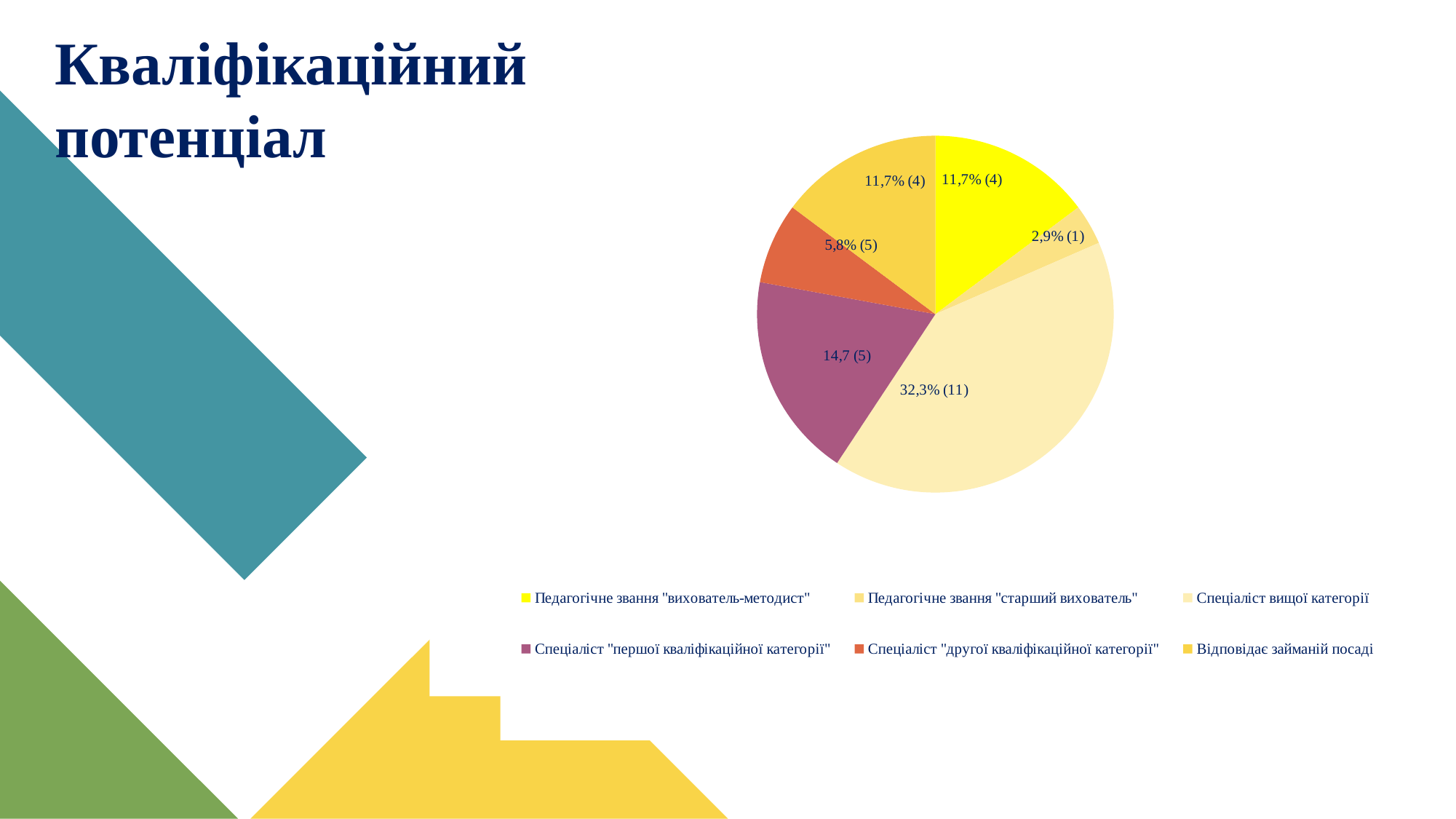
What is the title of the slide containing the chart? Кваліфікаційний потенціал How many slices does the pie chart have? 6 Which category has the smallest slice of the pie? Педагогічне звання "старший вихователь" What is the data label for the slice "Спеціаліст "другої кваліфікаційної категорії""? 5,8% (5) What is the data label for the slice "Спеціаліст вищої категорії"? 32,3% (11) How many entries does the legend list? 6 Which slice is larger: "Спеціаліст "першої кваліфікаційної категорії"" or "Спеціаліст "другої кваліфікаційної категорії""? Спеціаліст "першої кваліфікаційної категорії" What is the data label for the slice "Педагогічне звання "вихователь-методист""? 11,7% (4) What is the data label for the slice "Педагогічне звання "старший вихователь""? 2,9% (1) Which category has the largest slice of the pie? Спеціаліст вищої категорії What is the data label for the slice "Спеціаліст "першої кваліфікаційної категорії""? 14,7 (5) What kind of chart is shown on the slide? pie chart